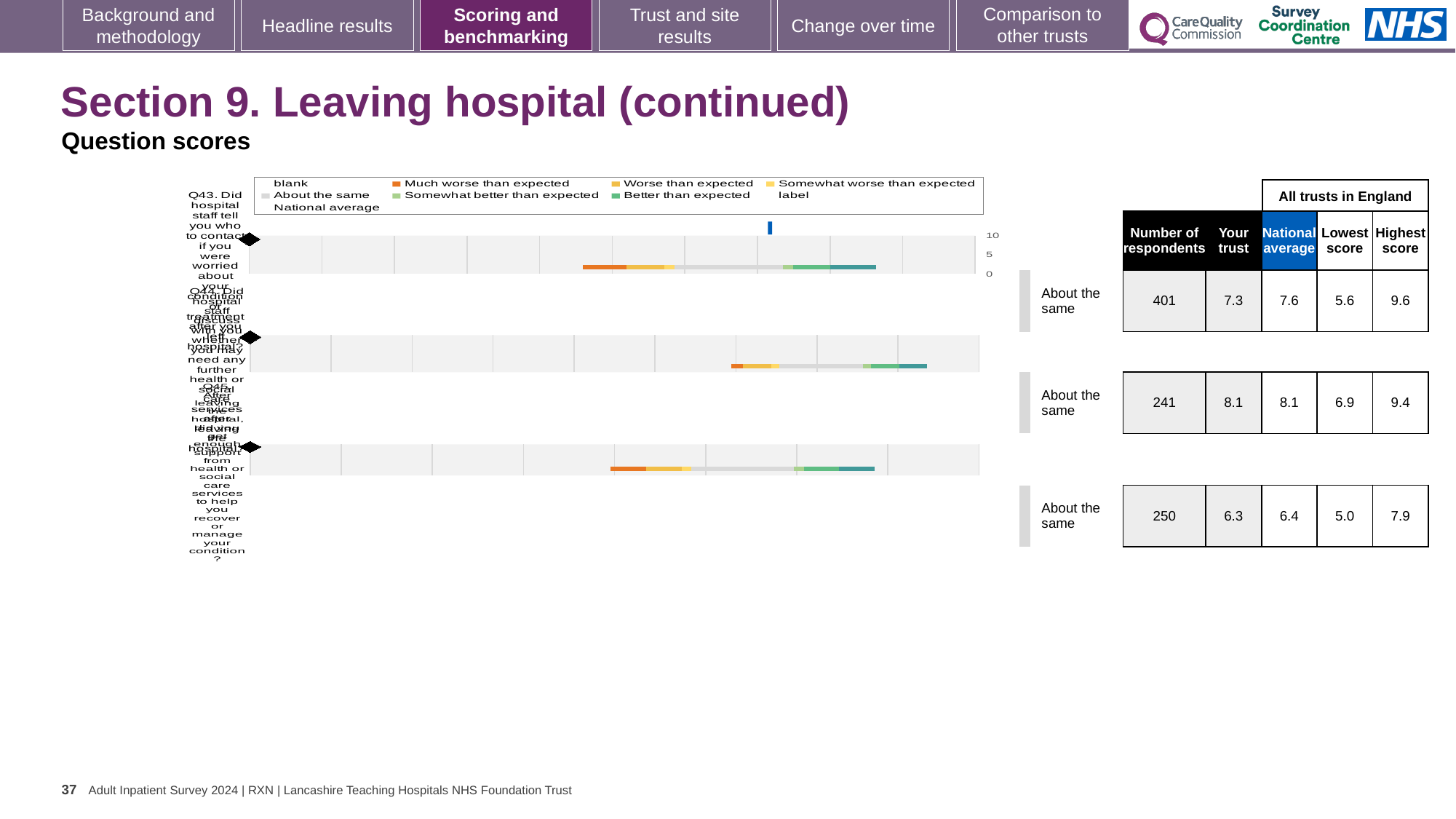
What benchmark category is shown next to the Q43 bar? About the same For Q44, what is the lowest score among all trusts in England? 6.9 For Q44 (discussing further health or social care services), what is the national average score? 8.1 Which question has the lowest 'Your trust' score on this slide? Q45 What kind of chart is used to show the question scores on this slide? bar chart Which question has the highest 'Your trust' score on this slide? Q44 For Q45, what is the difference between the highest score (7.9) and the lowest score (5.0) across all trusts in England? 2.9 For Q43 (who to contact if worried after leaving hospital), what is the 'Your trust' score? 7.3 For Q45 (enough support from health or social care services after leaving hospital), how many respondents are there? 250 For Q43, which is larger: the 'Your trust' score or the national average? National average How many questions (Q43, Q44, Q45) have a benchmark bar on this slide? 3